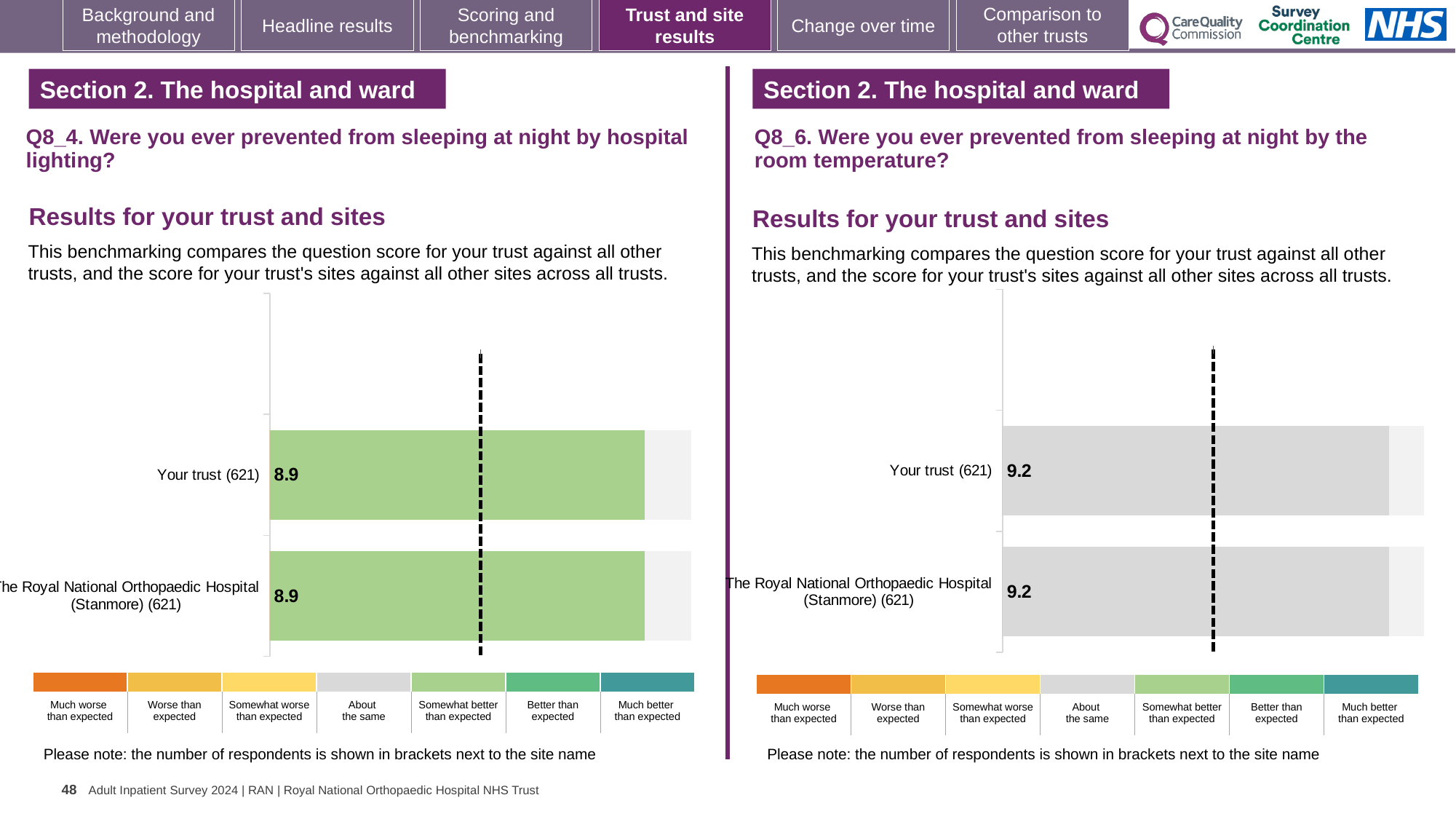
In the Q8_4 hospital lighting chart, what is the score for The Royal National Orthopaedic Hospital (Stanmore) (621)? 8.9 In the Q8_6 room temperature chart, what is the difference between the score for Your trust and the score for The Royal National Orthopaedic Hospital (Stanmore)? 0 How many bars are plotted in the Q8_4 hospital lighting chart? 2 What kind of chart is used for the Q8_4 hospital lighting results? Bar chart In the Q8_4 hospital lighting chart, what is the score for Your trust (621)? 8.9 In the Q8_6 room temperature chart, what is the score for Your trust (621)? 9.2 Is the score for Your trust in the Q8_6 room temperature chart higher or lower than the score for Your trust in the Q8_4 hospital lighting chart? Higher In the Q8_4 hospital lighting chart, which benchmark category does the colour of the bars correspond to? Somewhat better than expected In the Q8_4 hospital lighting chart, what is the difference between the score for Your trust and the score for The Royal National Orthopaedic Hospital (Stanmore)? 0 In the Q8_6 room temperature chart, what is the score for The Royal National Orthopaedic Hospital (Stanmore) (621)? 9.2 In the Q8_6 room temperature chart, which benchmark category does the colour of the bars correspond to? About the same How many bars are plotted in the Q8_6 room temperature chart? 2